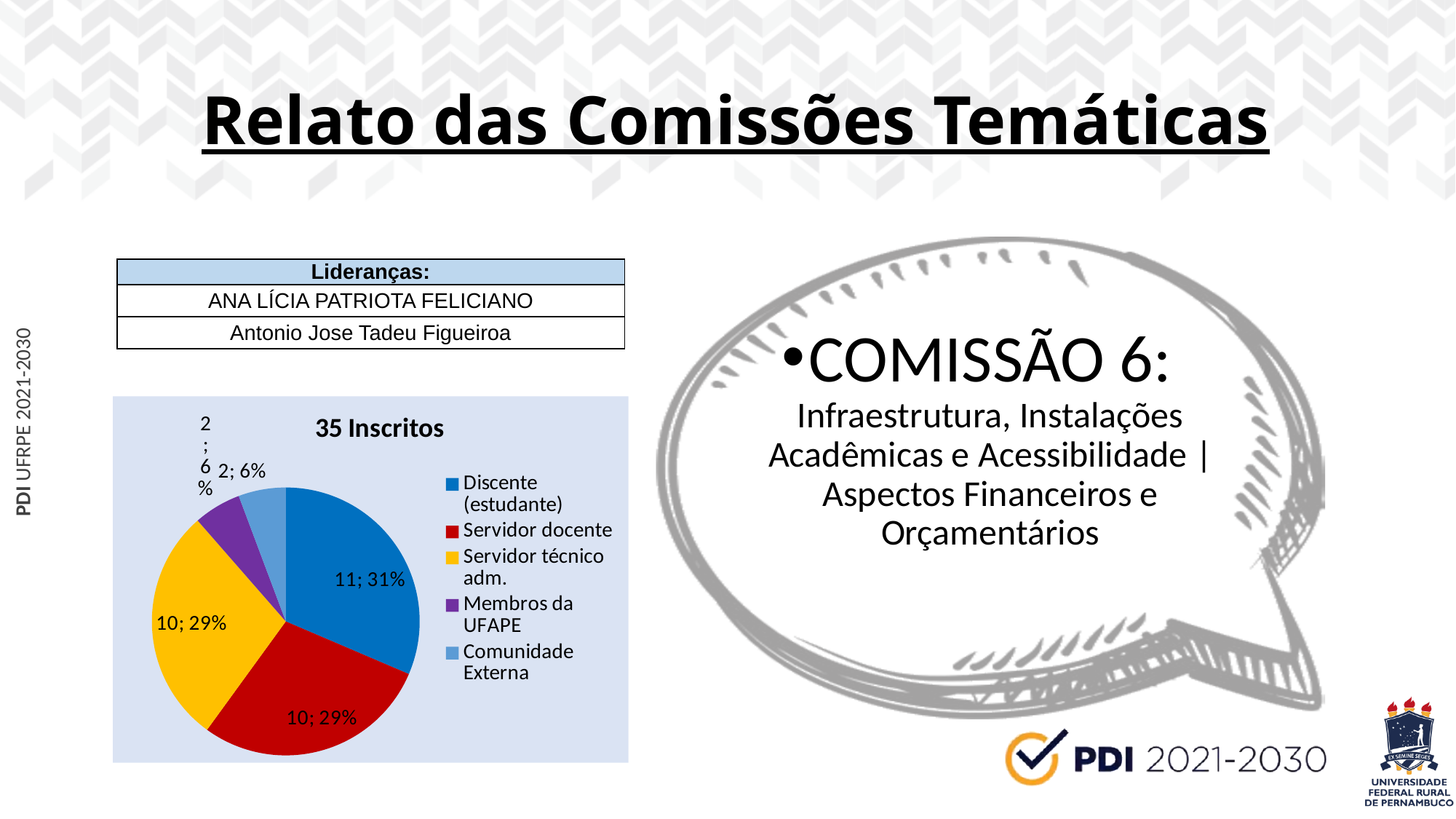
What share of the pie does Discente (estudante) represent? 31% How many inscritos are in the Servidor docente category? 10 What is the title of the pie chart? 35 Inscritos How many inscritos are in the Discente (estudante) category? 11 How many categories does the pie chart legend list? 5 What type of chart is shown on the slide? pie chart How many inscritos are in the Membros da UFAPE category? 2 Which is larger, Discente (estudante) or Servidor docente? Discente (estudante) What share of the pie does Comunidade Externa represent? 6% What percentage of the pie is Servidor técnico adm.? 29% Which category has the largest slice of the pie? Discente (estudante) What is the difference in inscritos between Discente (estudante) and Servidor técnico adm.? 1